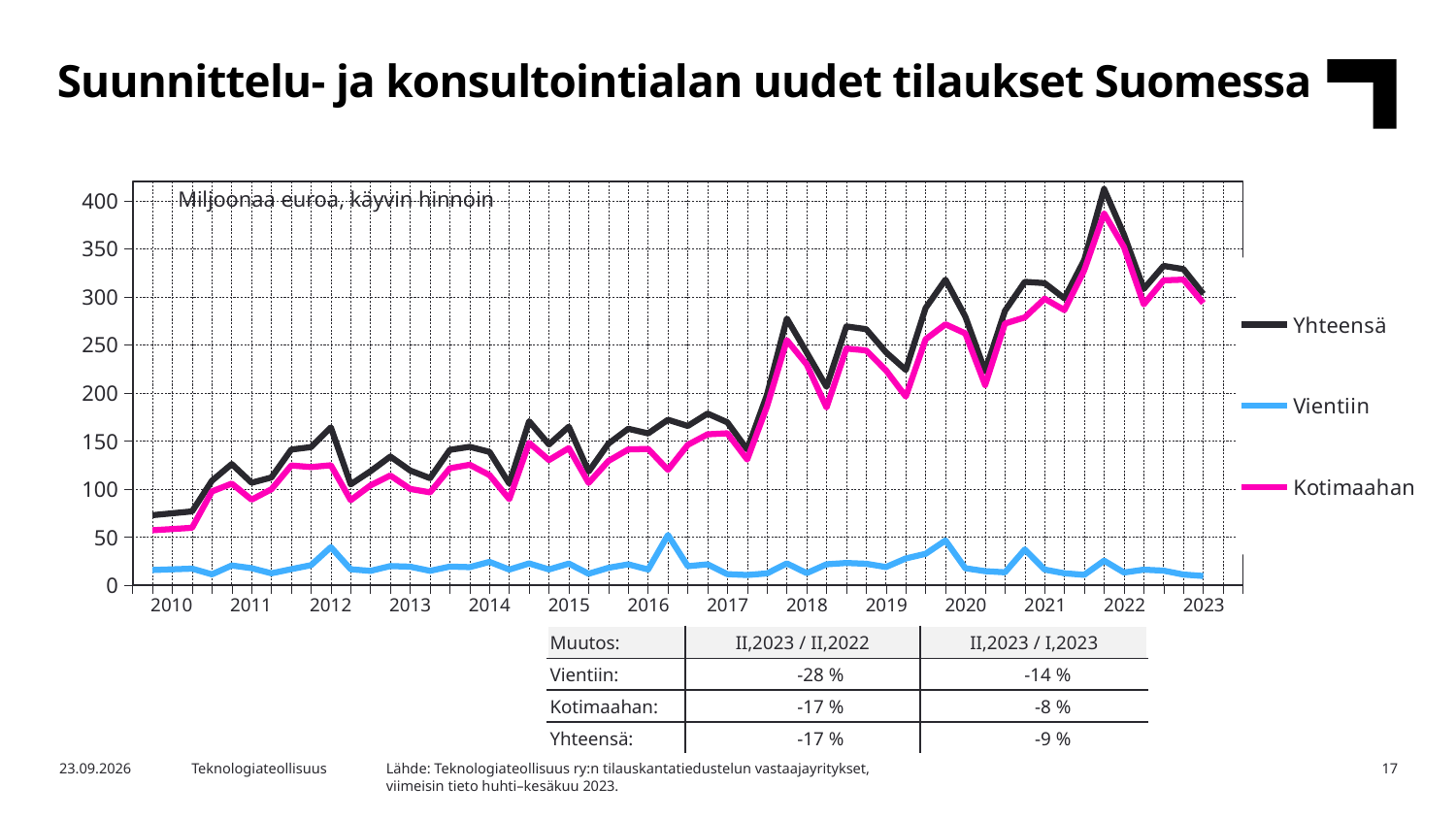
Which series has the lowest values throughout the chart? Vientiin Is the value for Vientiin at the start of 2010 greater or less than 50? less Is the peak value of Yhteensä in late 2021 greater or less than 400? greater How many series does the chart legend list? 3 What kind of chart is shown on the slide? line chart Which series are listed in the chart legend? Yhteensä, Vientiin, Kotimaahan Is the peak value of Kotimaahan in late 2021 greater or less than 350? greater Which series has the highest values throughout the chart? Yhteensä What unit is stated in the chart's subtitle? Miljoonaa euroa, käyvin hinnoin Does the Yhteensä series generally rise or fall from 2010 to 2023? rise How many year labels are shown on the x axis? 14